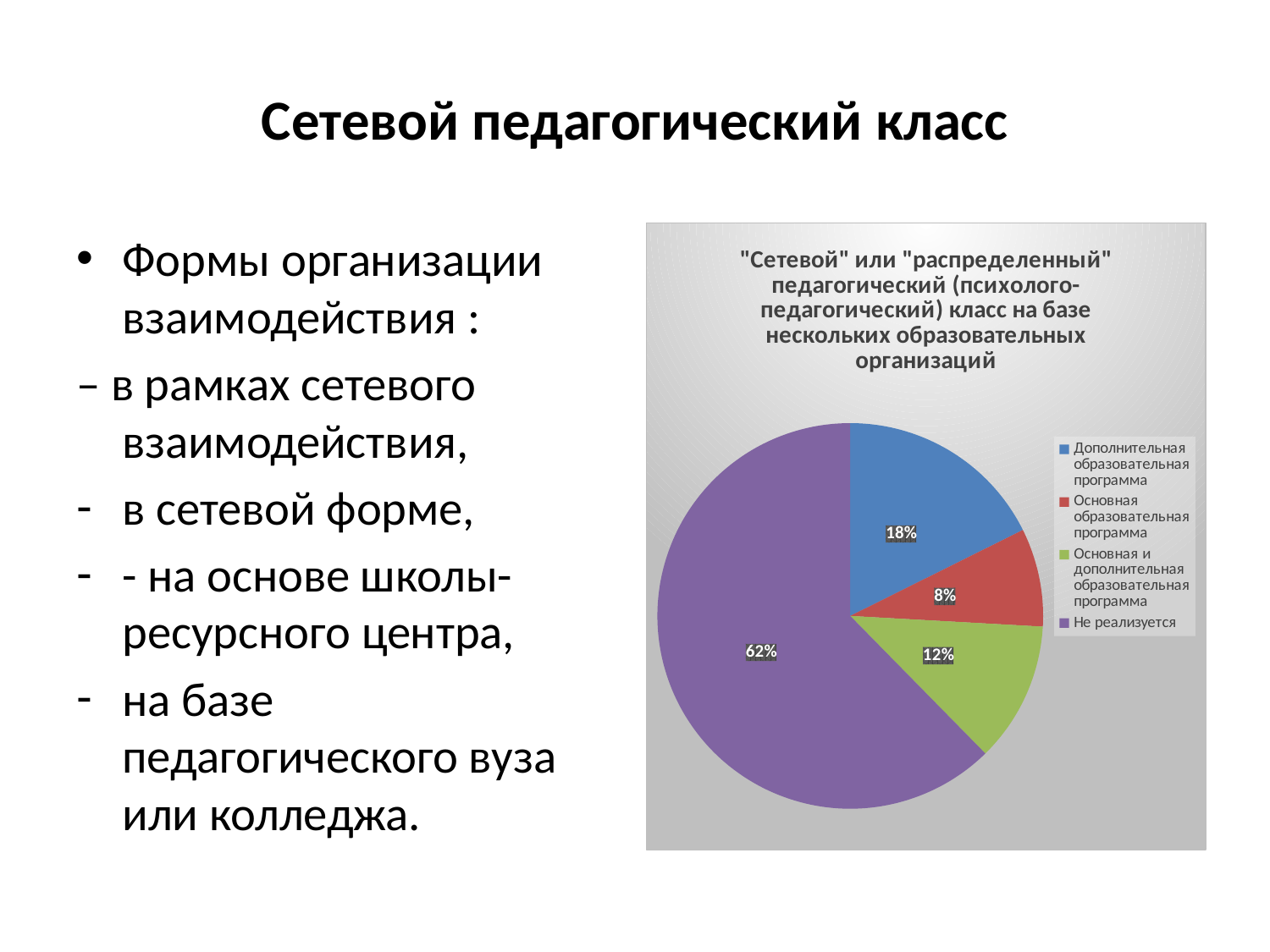
What share of the pie is labelled "Основная образовательная программа"? 8% How many slices does the pie chart have? 4 What type of chart is shown on the slide? pie chart Which is larger: the slice for "Дополнительная образовательная программа" or the slice for "Основная и дополнительная образовательная программа"? Дополнительная образовательная программа What colour is the slice for "Не реализуется"? purple What share of the pie is labelled "Дополнительная образовательная программа"? 18% What share of the pie is labelled "Основная и дополнительная образовательная программа"? 12% Which category has the largest slice of the pie? Не реализуется What share of the pie is labelled "Не реализуется"? 62% Which category has the smallest slice of the pie? Основная образовательная программа What is the difference in percentage points between "Не реализуется" and "Дополнительная образовательная программа"? 44 How many entries does the legend list? 4